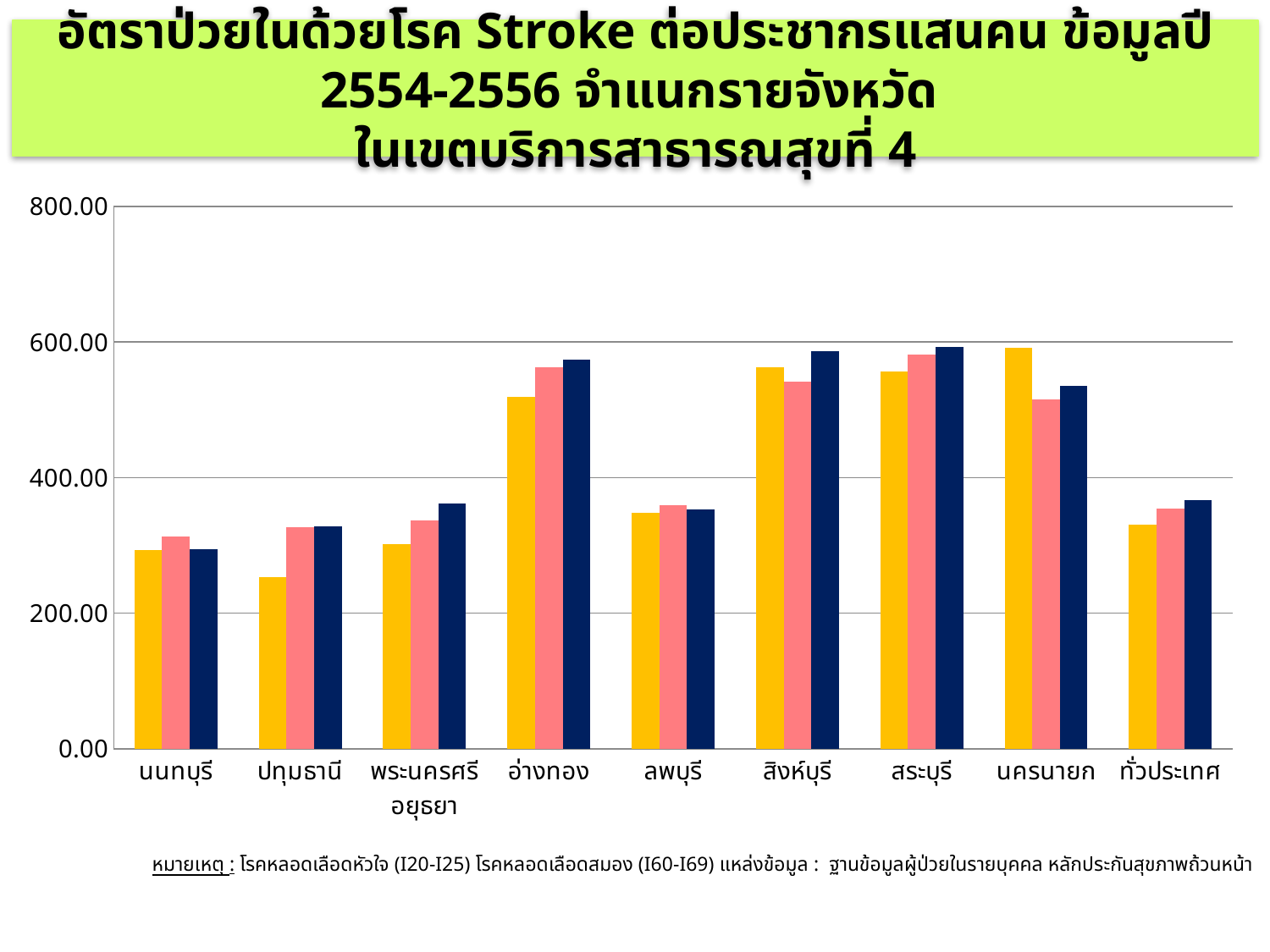
Which category has the lowest dark blue bar? นนทบุรี Is the yellow bar for อ่างทอง greater or less than 400? greater What kind of chart is shown on the slide? bar chart Is the dark blue bar for ทั่วประเทศ greater or less than 400? less Which province has the lowest yellow bar? ปทุมธานี Is the yellow bar for ปทุมธานี greater or less than 400? less How many bars are plotted for each province on the x axis? 3 Which is larger: the yellow bar for นครนายก or the yellow bar for ปทุมธานี? นครนายก How many categories are shown along the x axis? 9 Which category has the highest yellow bar? นครนายก Which is larger: the pink bar for อ่างทอง or the pink bar for ลพบุรี? อ่างทอง